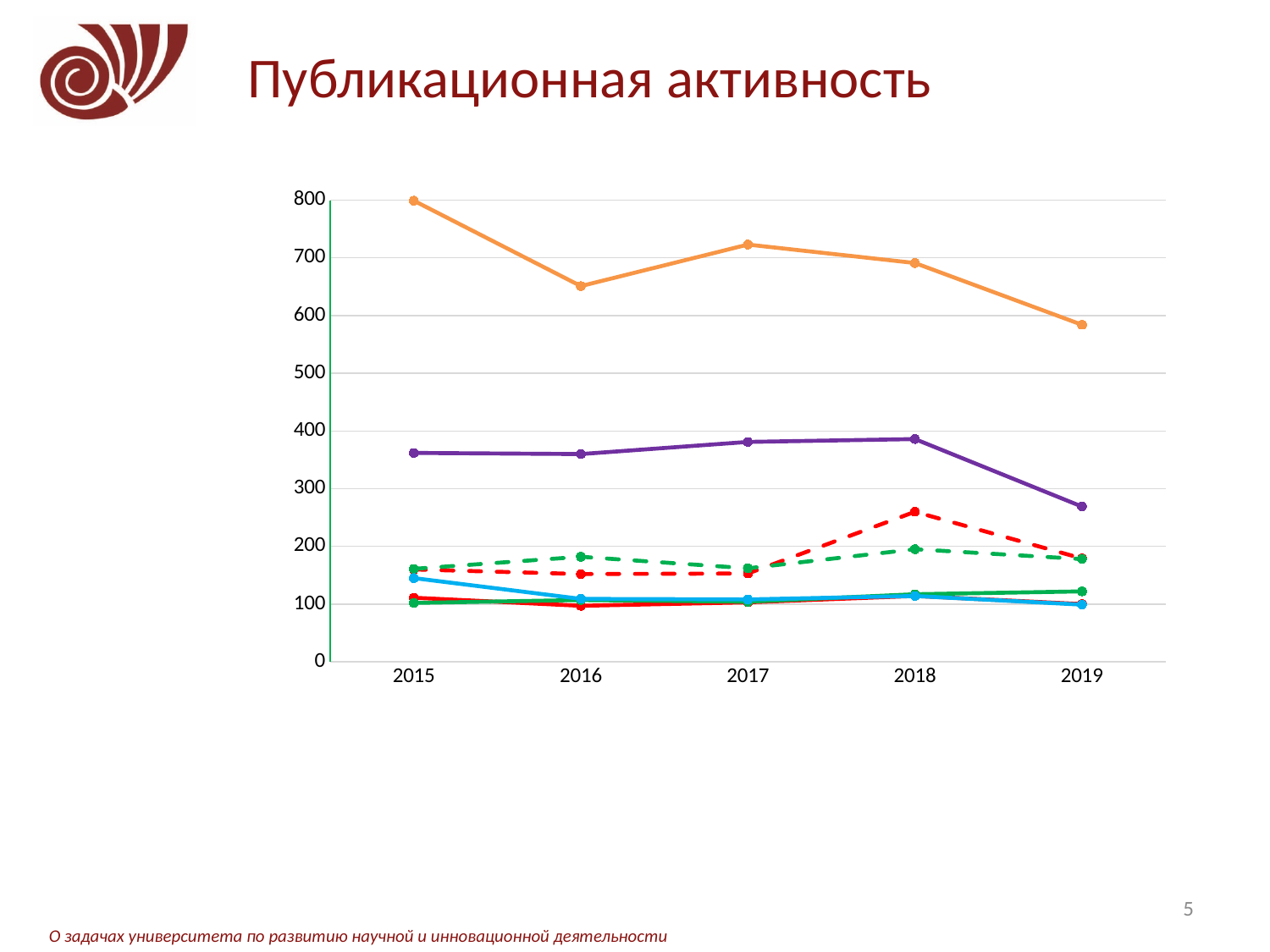
Is the value of the orange line in 2015 greater or less than 700? greater Does the purple line rise or fall from 2018 to 2019? fall In 2015, which is larger: the orange line or the purple line? the orange line Which year has the highest value on the orange line? 2015 In 2018, which is larger: the red dashed line or the green dashed line? the red dashed line What kind of chart is shown on the slide? line chart Is the value of the purple line in 2019 greater or less than 300? less Which year has the lowest value on the purple line? 2019 How many years are shown on the x axis of the chart? 5 Is the value of the red dashed line in 2018 greater or less than 200? greater What is the title of the slide with the chart? Публикационная активность Which year has the lowest value on the orange line? 2019